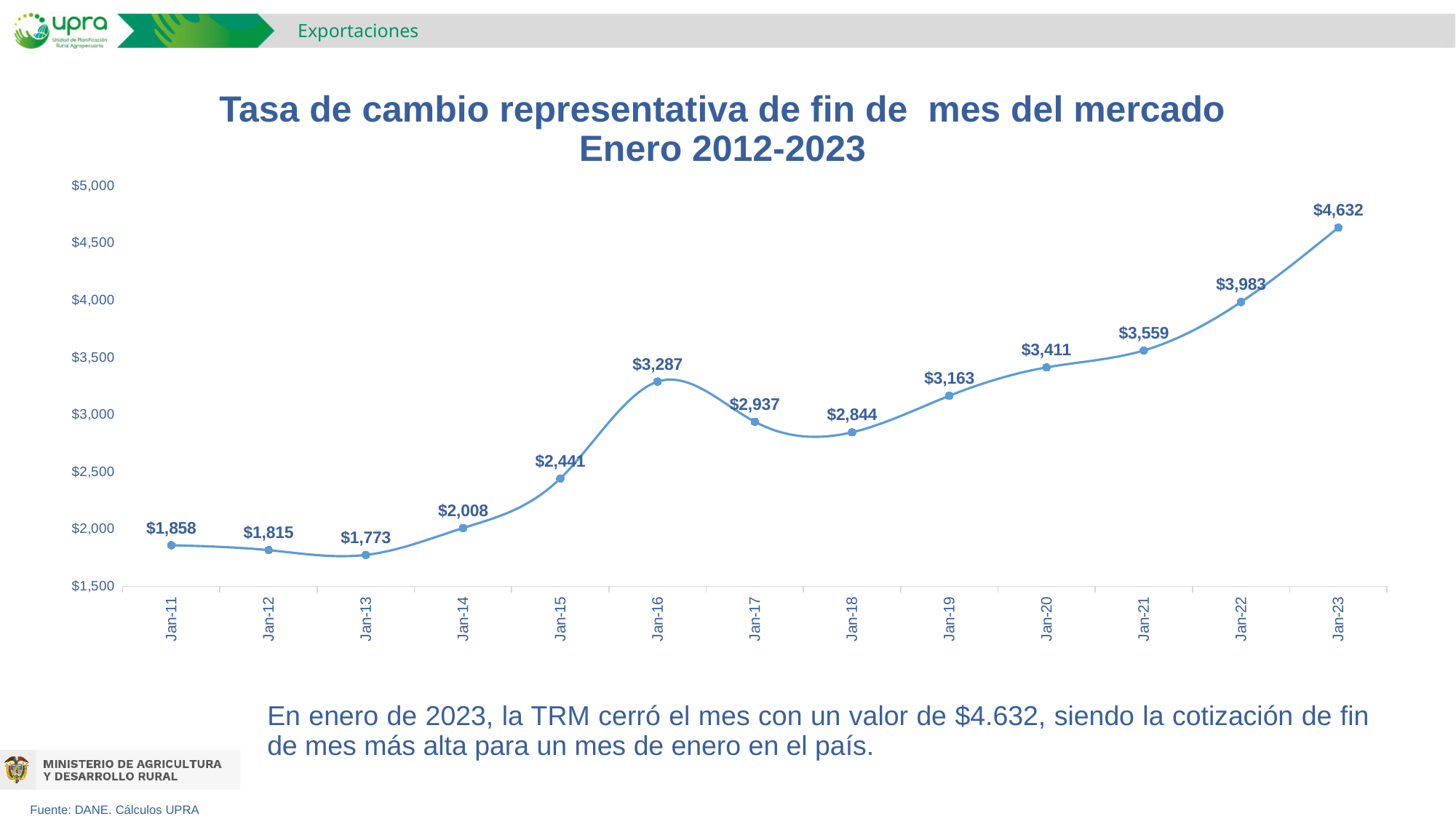
What is the value for Jan-20? $3,411 What is the value for Jan-16? $3,287 How many data points are plotted on the chart? 13 Does the value rise or fall from Jan-16 to Jan-18? Fall What is the title of the chart? Tasa de cambio representativa de fin de mes del mercado Enero 2012-2023 Which is larger, the value for Jan-17 or the value for Jan-19? Jan-19 Which point has the lowest value? Jan-13 What is the difference between the values for Jan-23 and Jan-22? $649 What is the difference between the values for Jan-16 and Jan-17? $350 What type of chart is shown on the slide? Line chart What is the value for Jan-13? $1,773 Which point has the highest value? Jan-23